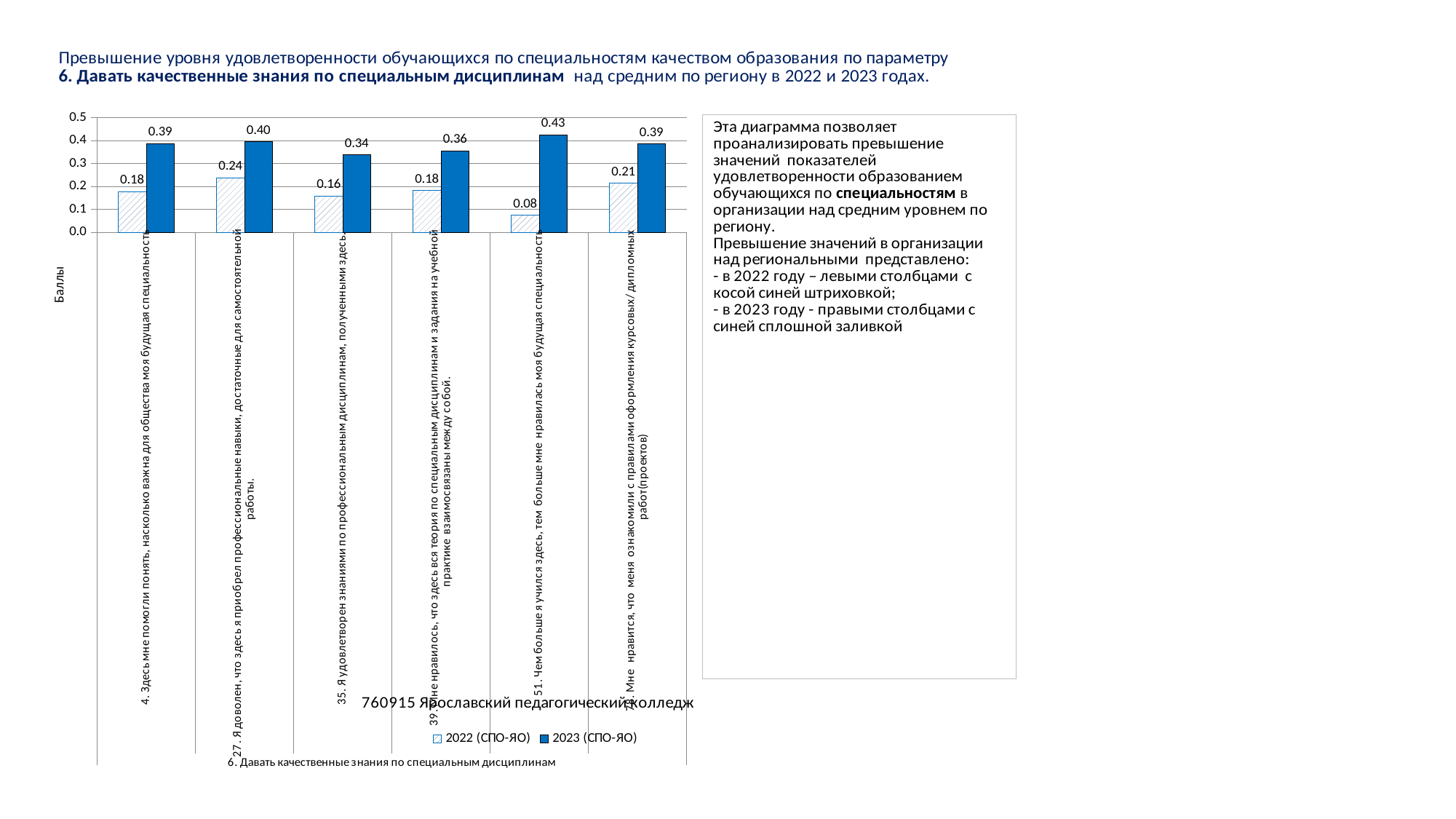
Which statement has the highest 2023 (СПО-ЯО) value? 51. Чем больше я учился здесь, тем больше мне нравилась моя будущая специальность What is the label of the y axis? Баллы Is the 2023 (СПО-ЯО) value for statement 35 «Я удовлетворен знаниями по профессиональным дисциплинам, полученными здесь» greater or less than 0.3? greater How many series does the legend list? 2 What is the 2022 (СПО-ЯО) value for statement 35 «Я удовлетворен знаниями по профессиональным дисциплинам, полученными здесь»? 0.16 Which is larger for statement 39 «Мне нравилось, что здесь вся теория по специальным дисциплинам и задания на учебной практике взаимосвязаны между собой»: the 2022 value or the 2023 value? 2023 value What type of chart is shown on the slide? bar chart What is the 2022 (СПО-ЯО) value for statement 27 «Я доволен, что здесь я приобрел профессиональные навыки, достаточные для самостоятельной работы»? 0.24 What is the difference between the 2023 and 2022 values for statement 51 «Чем больше я учился здесь, тем больше мне нравилась моя будущая специальность»? 0.35 Which statement has the lowest 2022 (СПО-ЯО) value? 51. Чем больше я учился здесь, тем больше мне нравилась моя будущая специальность What is the 2023 (СПО-ЯО) value for statement 51 «Чем больше я учился здесь, тем больше мне нравилась моя будущая специальность»? 0.43 How many categories (statements) are plotted on the x axis? 6